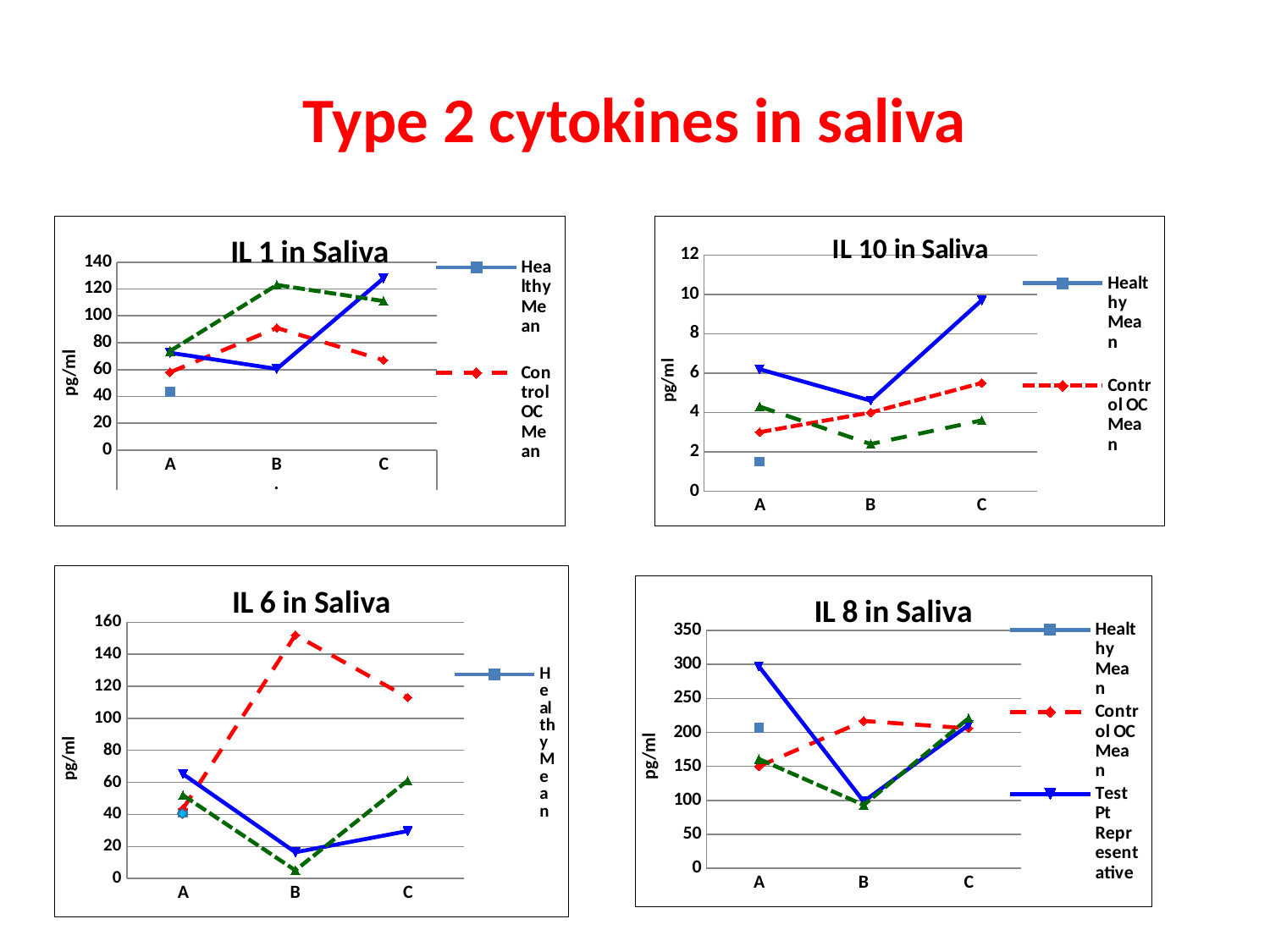
What is the title of the chart in the bottom-left of the slide? IL 6 in Saliva In the 'IL 1 in Saliva' chart, which is larger at B: the Control OC Mean or the solid blue line? Control OC Mean In the 'IL 6 in Saliva' chart, does the Control OC Mean rise or fall from B to C? fall How many categories are shown on the x axis of the 'IL 8 in Saliva' chart? 3 In the 'IL 8 in Saliva' chart, is the Control OC Mean value at B greater or less than 200? greater In the 'IL 1 in Saliva' chart, is the Control OC Mean value at B greater or less than 80? greater What is the y-axis label on the 'IL 10 in Saliva' chart? pg/ml How many series does the legend of the 'IL 8 in Saliva' chart list? 3 In the 'IL 10 in Saliva' chart, is the Control OC Mean value at A greater or less than 4? less What kind of chart is the 'IL 1 in Saliva' chart? line chart